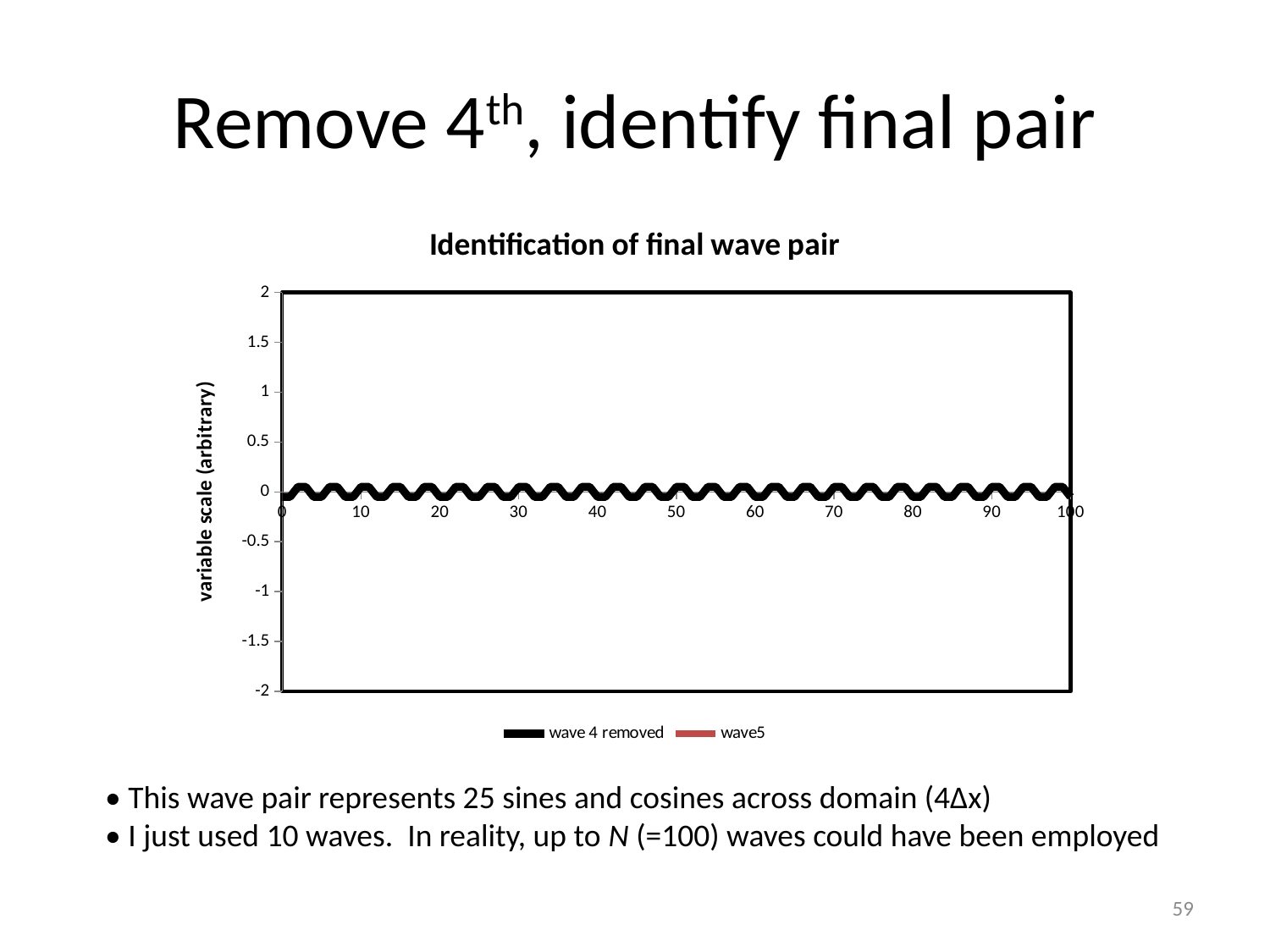
What is the highest tick value shown on the vertical axis? 2 What is the title of the chart? Identification of final wave pair Is the value of the plotted wave at x = 80 greater or less than 1? less What is the label of the vertical axis? variable scale (arbitrary) How many series does the chart's legend list? 2 Is the value of the plotted wave at x = 50 greater or less than 0.5? less Is the value of the plotted wave at x = 10 greater or less than -1? greater What kind of chart is shown on the slide? line chart